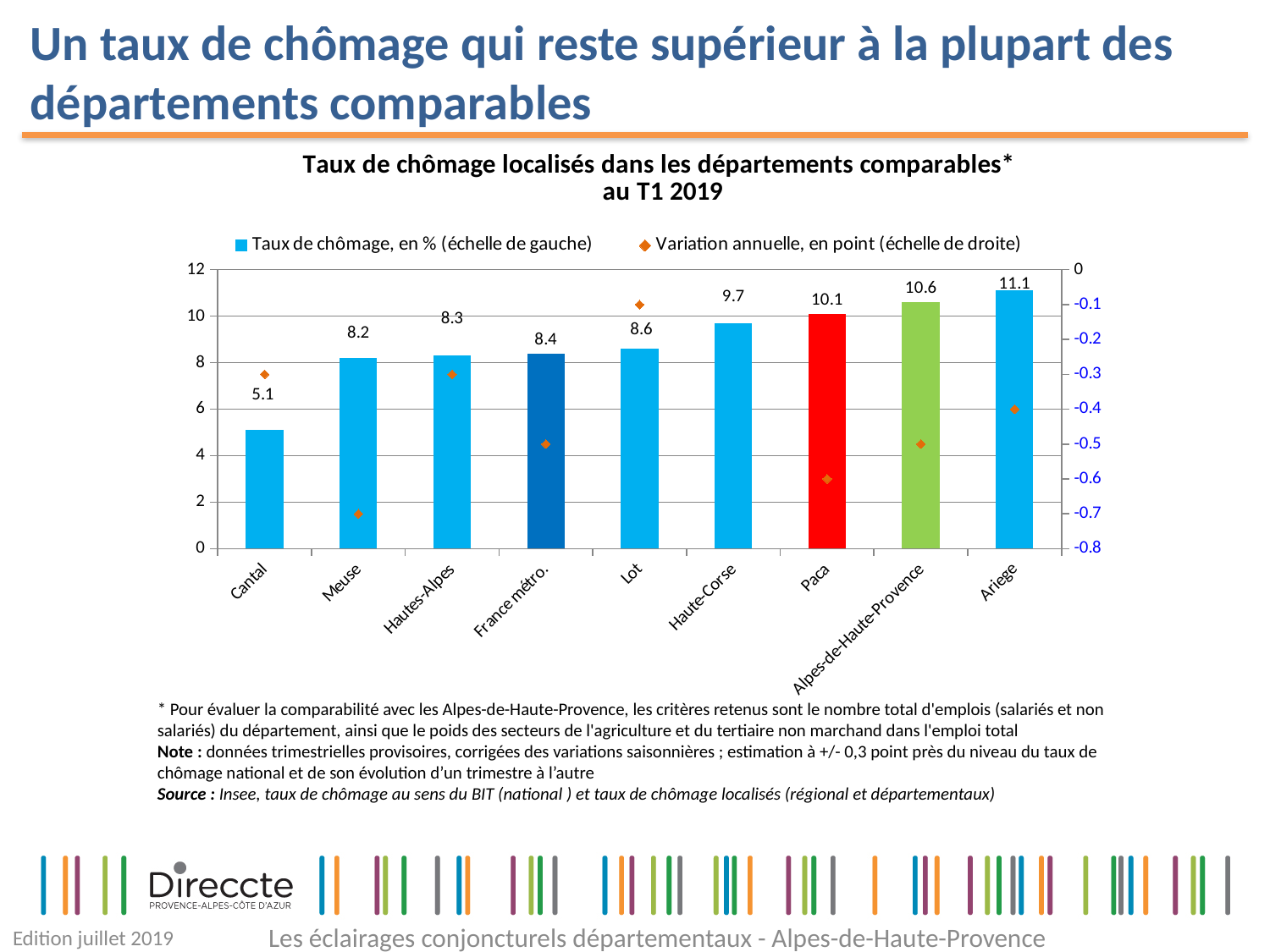
Which department has the highest unemployment rate on the chart? Ariege Is the annual variation (Variation annuelle) for Meuse greater or less than -0.5 points? less What type of chart is used to show the unemployment rates? Bar chart Which department has the lowest unemployment rate on the chart? Cantal What is the difference between the unemployment rates of Ariège and Cantal? 6.0 What is the unemployment rate shown for Cantal? 5.1 Is the annual variation for Lot greater or less than -0.3 points? greater What is the unemployment rate (taux de chômage) shown for Alpes-de-Haute-Provence? 10.6 Which has a higher unemployment rate, Paca or Haute-Corse? Paca How many series does the legend list? 2 What is the unemployment rate shown for France métro.? 8.4 How many departments or areas are shown on the x axis of the chart? 9